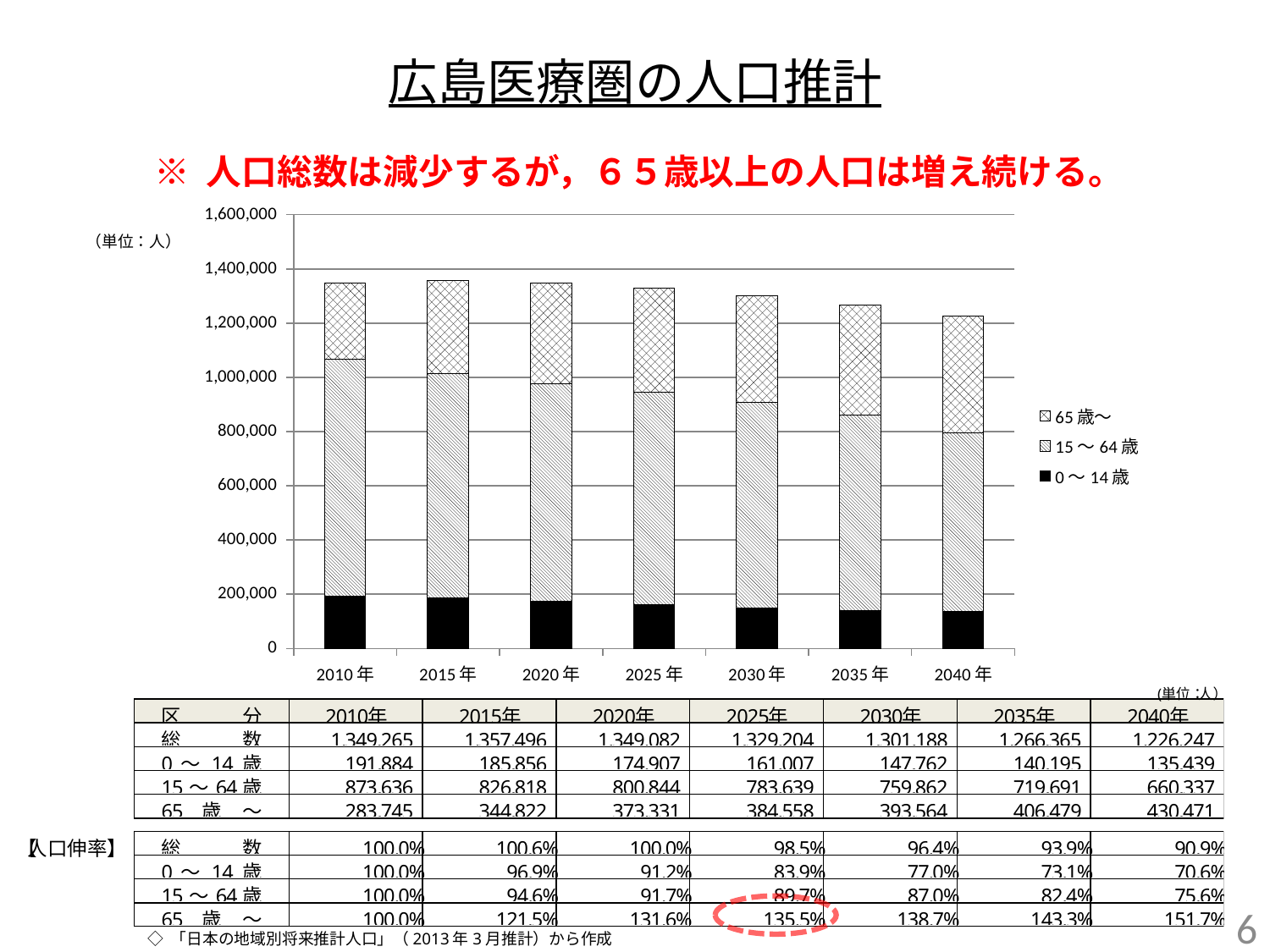
According to the table, what is the 65歳～ population in 2040年? 430,471 What is the total population (総数) for the 2010年 bar? 1,349,265 What kind of chart is shown on the slide? stacked bar chart What are the three series listed in the chart's legend? 65歳～, 15～64歳, 0～14歳 How many years (categories) are plotted along the x axis of the chart? 7 Which year has the lowest 15～64歳 population? 2040年 Does the 0～14歳 segment rise or fall from 2010年 to 2040年? fall Does the 65歳～ segment rise or fall from 2010年 to 2040年? rise How many series does the chart's legend list? 3 Which year has the highest total population (総数)? 2015年 Is the total height of the 2040年 bar greater or less than 1,400,000? less By how much does the 65歳～ population in 2040年 exceed that in 2010年? 146,726